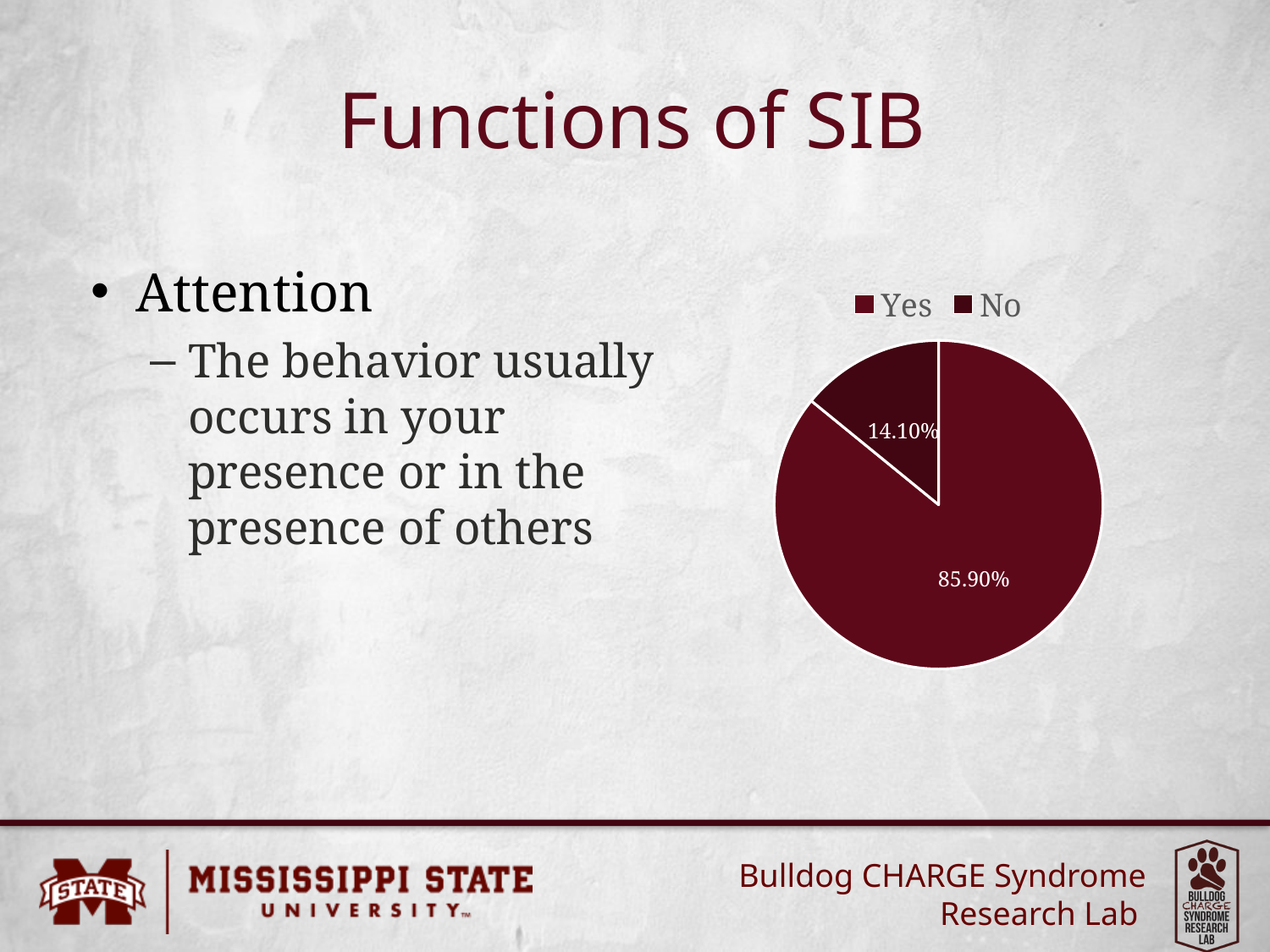
How many slices does the pie chart have? 2 What percentage of the pie chart is labelled No? 14.10% What percentage of the pie chart is labelled Yes? 85.90% What share of the pie does the Yes slice represent? 85.90% Is the No slice of the pie chart greater or less than 50%? less What is the difference in percentage points between the Yes and No slices? 71.80% Which slice of the pie chart is the smallest? No What are the two legend entries of the pie chart? Yes and No How many entries does the legend of the pie chart list? 2 Which is larger in the pie chart, Yes or No? Yes Which slice of the pie chart is the largest? Yes What kind of chart is shown on the slide? pie chart